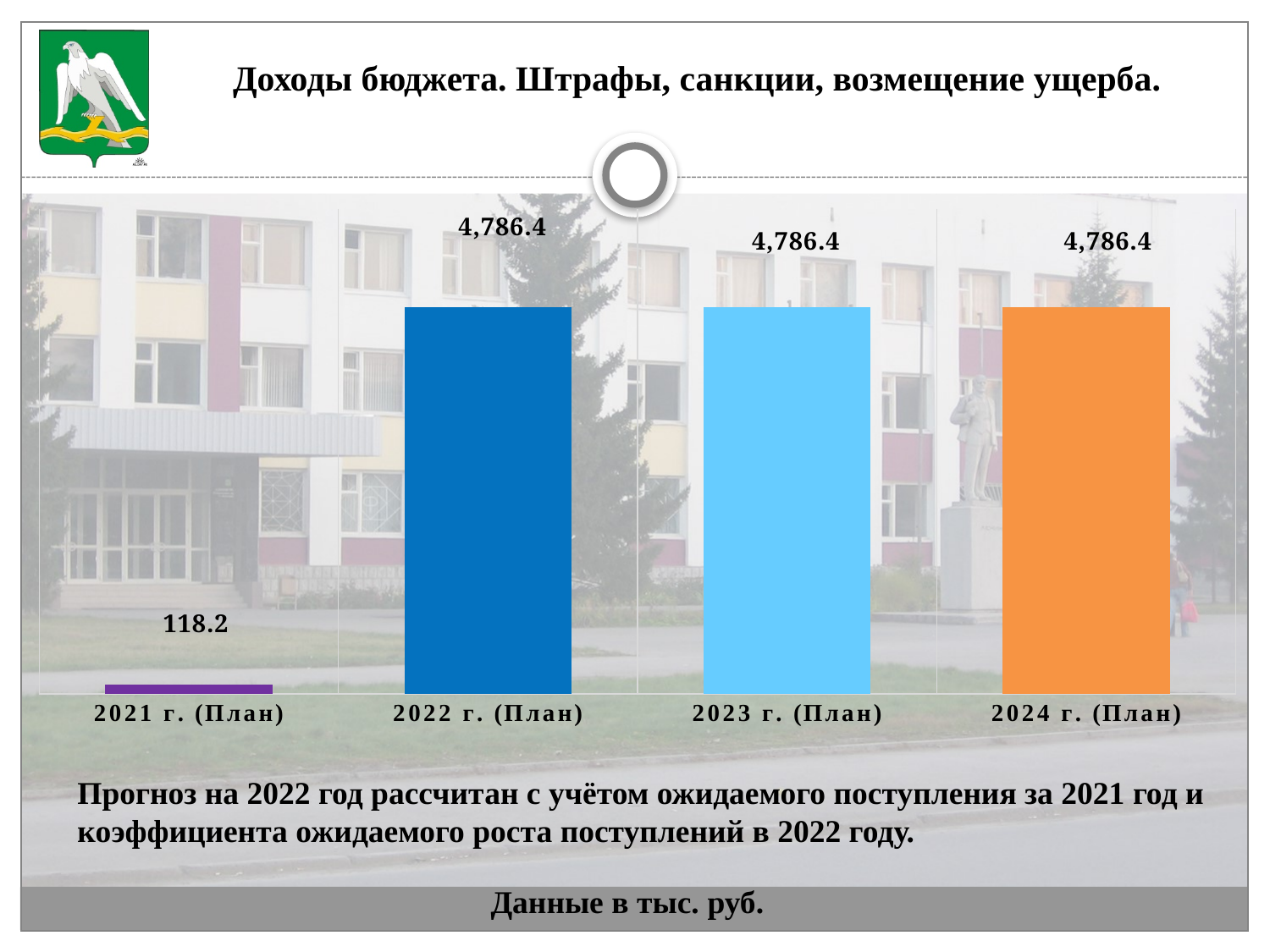
Are the values for 2022, 2023 and 2024 (План) the same or different? the same What is the value for 2024 г. (План)? 4,786.4 What is the value for 2021 г. (План)? 118.2 Which is larger, the value for 2021 г. (План) or the value for 2023 г. (План)? 2023 г. (План) What is the value for 2022 г. (План)? 4,786.4 What is the difference between the values for 2022 г. (План) and 2021 г. (План)? 4,668.2 What kind of chart is shown on the slide? bar chart Do the values rise or fall from 2021 г. (План) to 2022 г. (План)? rise What is the title of the chart on the slide? Доходы бюджета. Штрафы, санкции, возмещение ущерба. How many categories are shown on the chart? 4 Which category has the lowest value? 2021 г. (План) In what units are the data on the chart given? тыс. руб.